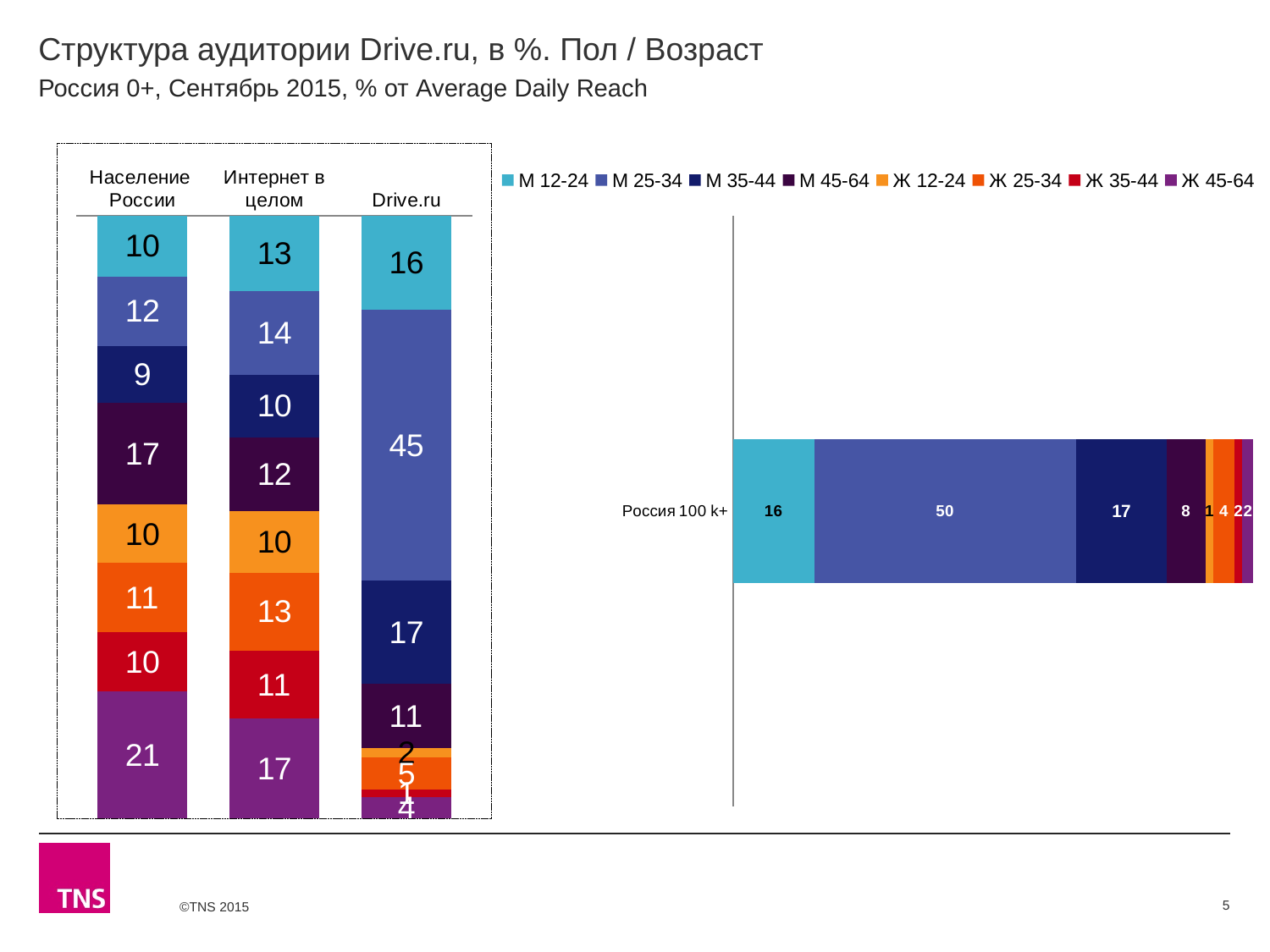
In the left chart, what is the value of М 12-24 for Интернет в целом? 13 In the left chart, which is larger: Ж 45-64 for Население России or Ж 45-64 for Интернет в целом? Население России In the left chart, which segment is the smallest in the Население России bar? М 35-44 In the left chart, what is the value of М 25-34 for Drive.ru? 45 In the right chart, what is the value of М 45-64 for Россия 100 k+? 8 How many bars are in the left chart? 3 In the right chart, what is the value of М 25-34 for Россия 100 k+? 50 In the left chart, which segment is the largest in the Drive.ru bar? М 25-34 How many series does the legend list? 8 In the left chart, what is the value of Ж 45-64 for Население России? 21 In the left chart, what is the difference between the М 25-34 values for Drive.ru and Население России? 33 What kind of chart is the right chart? Stacked bar chart